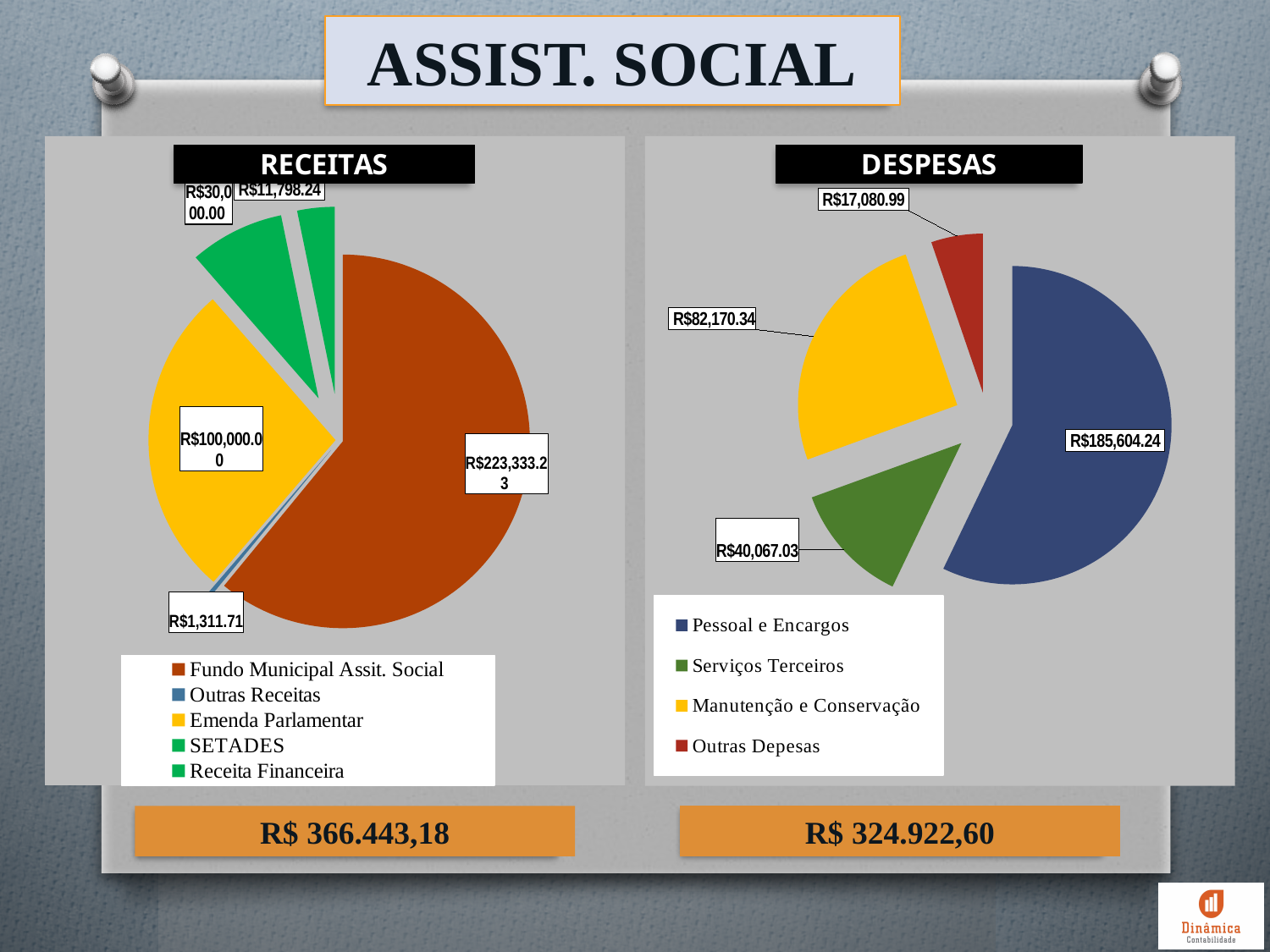
How many categories does the legend of the RECEITAS chart list? 5 In the DESPESAS chart, what is the value for Pessoal e Encargos? R$185,604.24 In the RECEITAS chart, which category has the smallest value? Outras Receitas In the DESPESAS chart, which category has the largest value? Pessoal e Encargos In the RECEITAS chart, what is the difference between Fundo Municipal Assit. Social and Emenda Parlamentar? R$123,333.23 In the DESPESAS chart, what is the difference between Pessoal e Encargos and Manutenção e Conservação? R$103,433.90 What colour is the Pessoal e Encargos slice in the DESPESAS chart? Blue In the RECEITAS chart, what is the value for Fundo Municipal Assit. Social? R$223,333.23 In the RECEITAS chart, what is the value for Emenda Parlamentar? R$100,000.00 In the DESPESAS chart, which is larger: Manutenção e Conservação or Outras Depesas? Manutenção e Conservação In the DESPESAS chart, what is the value for Serviços Terceiros? R$40,067.03 What type of chart is the RECEITAS chart? Pie chart